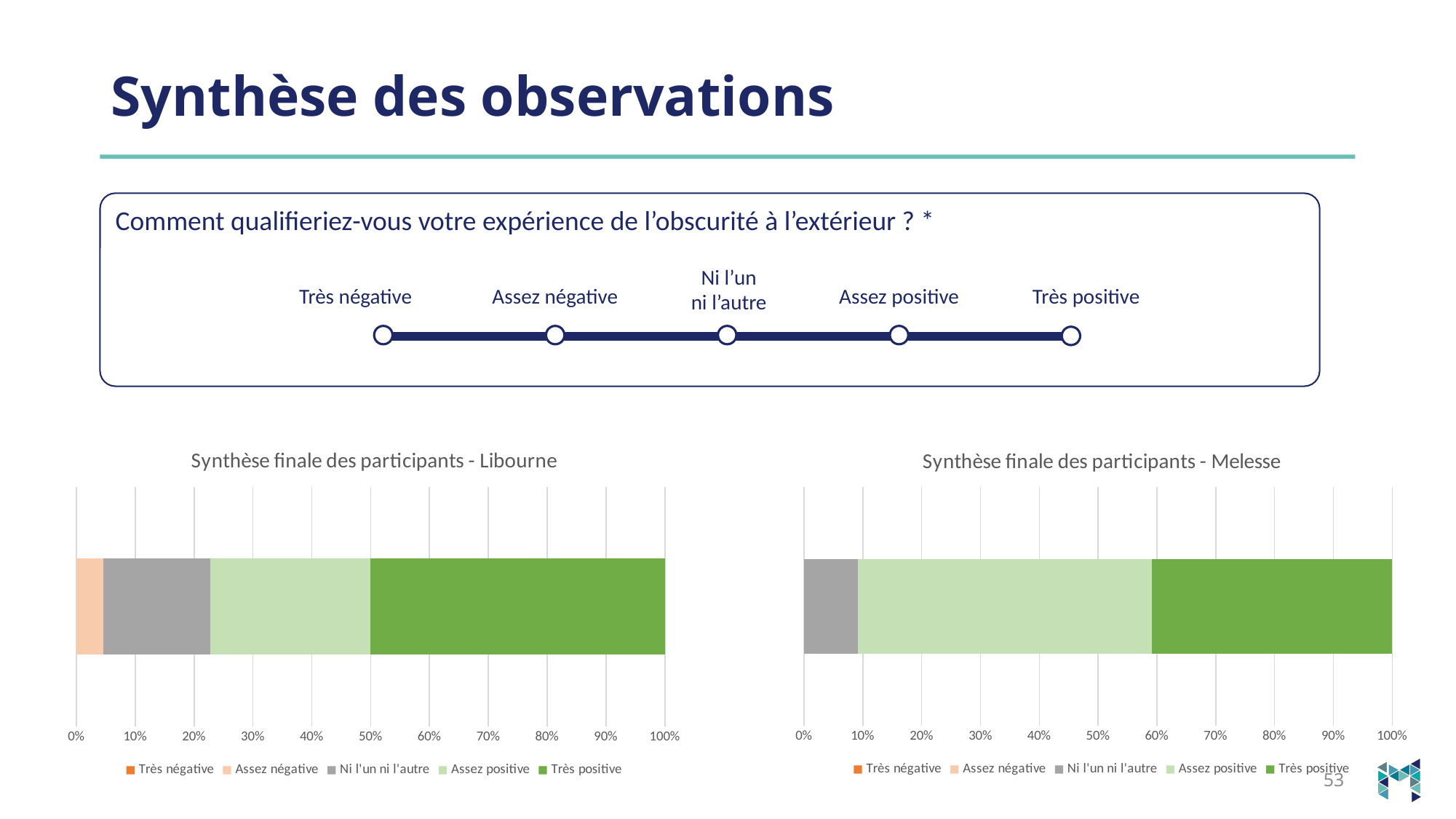
In the "Synthèse finale des participants - Libourne" chart, is the value for Très positive greater or less than 40%? greater What kind of chart is "Synthèse finale des participants - Libourne"? Stacked bar chart In the "Synthèse finale des participants - Melesse" chart, which is larger: Ni l'un ni l'autre or Très positive? Très positive In the "Synthèse finale des participants - Libourne" chart, is the value for Assez négative greater or less than 10%? less In the "Synthèse finale des participants - Libourne" chart, which response category takes the largest share of the bar? Très positive In the "Synthèse finale des participants - Melesse" chart, which response category takes the largest share of the bar? Assez positive What is the title of the chart on the right of the slide? Synthèse finale des participants - Melesse In the "Synthèse finale des participants - Melesse" chart, is the value for Assez positive greater or less than 40%? greater How many series does the legend of the "Synthèse finale des participants - Melesse" chart list? 5 In the "Synthèse finale des participants - Libourne" chart, which is larger: Très positive or Assez positive? Très positive In the "Synthèse finale des participants - Libourne" chart, what is the highest value shown on the horizontal axis? 100%